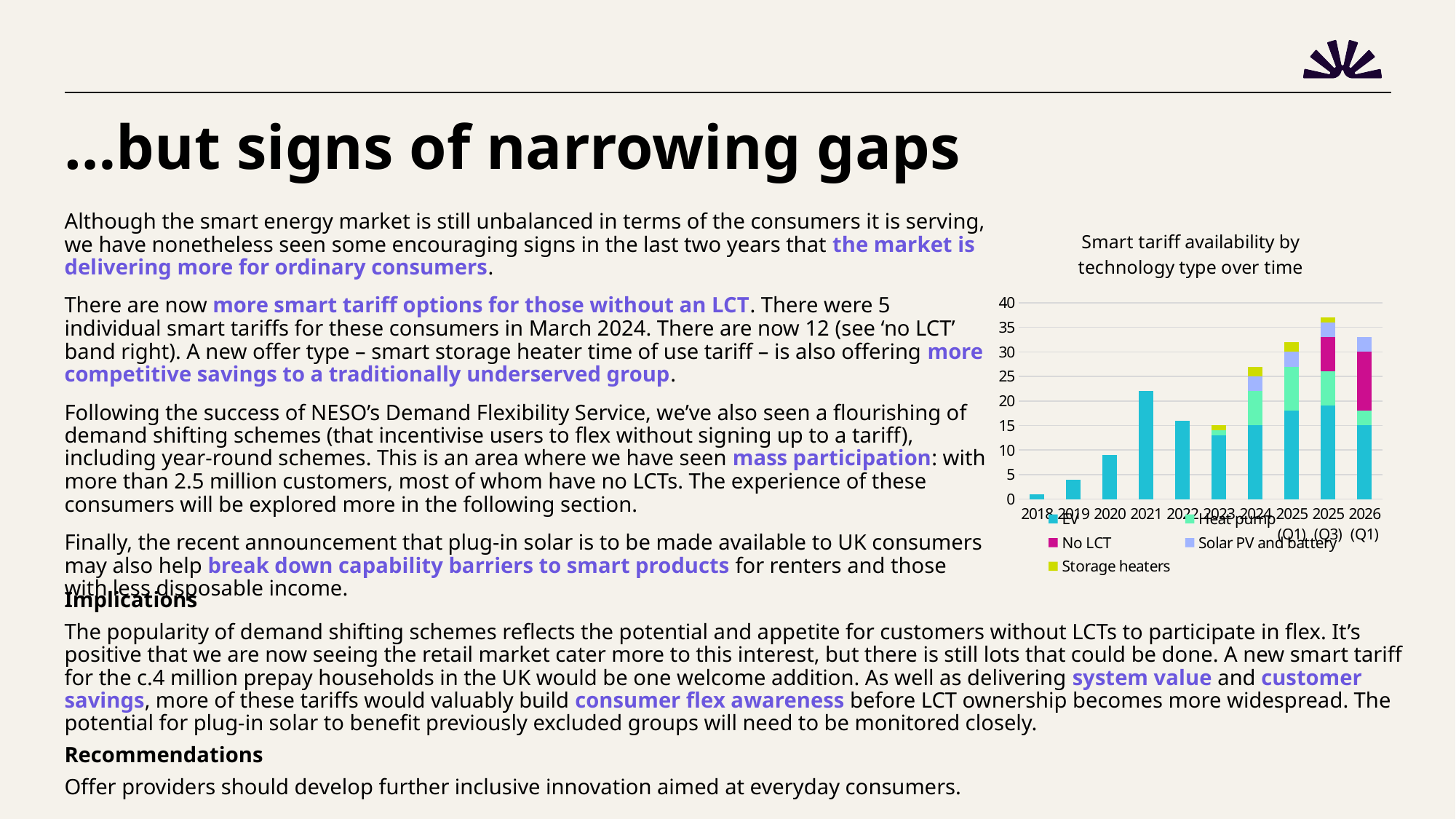
Which has a taller stacked bar, 2021 or 2022? 2021 How many series does the chart legend list? 5 What is the title of the chart? Smart tariff availability by technology type over time Is the total bar height for 2020 greater or less than 10? less Which time period has the shortest stacked bar? 2018 What kind of chart is shown on the slide? Stacked bar chart Is the total bar height for 2025 (Q3) greater or less than 35? greater Do the stacked bar totals rise or fall from 2018 to 2021? Rise Which time period has the tallest stacked bar? 2025 (Q3) Is the total bar height for 2021 greater or less than 20? greater How many time periods are shown along the x axis of the chart? 10 Which series in the legend is shown in magenta/pink? No LCT